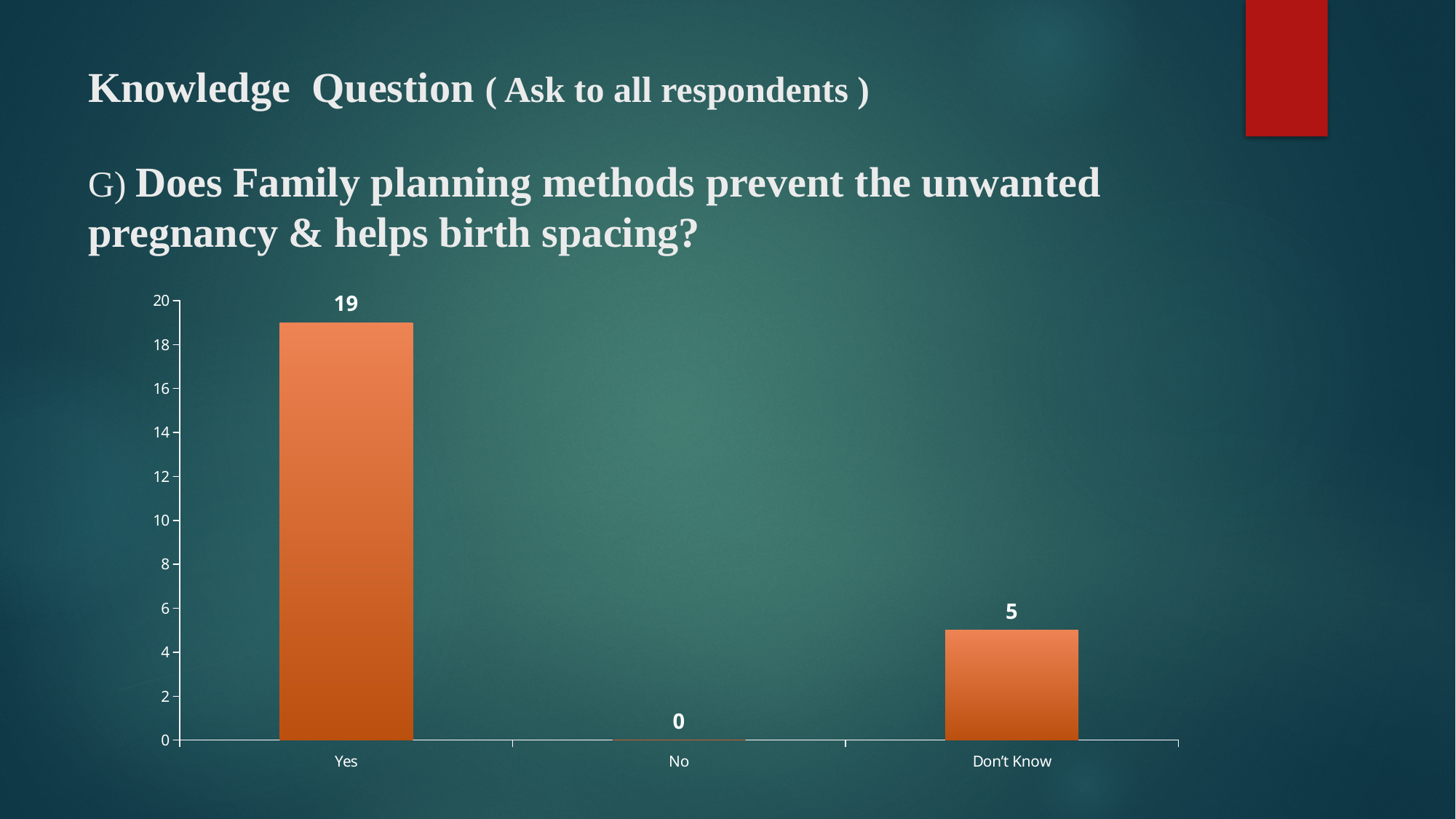
Which category has the lowest value? No Is the value for Yes greater or less than 10? greater What is the value for Yes? 19 What is the maximum value shown on the y axis? 20 What is the difference between the values for Yes and Don't Know? 14 Which category has the highest value? Yes What is the value for No? 0 Which is larger, the value for Don't Know or the value for No? Don't Know What kind of chart is shown on the slide? bar chart How many categories are shown on the x axis? 3 What is the total of the values for Yes, No and Don't Know? 24 What is the value for Don't Know? 5